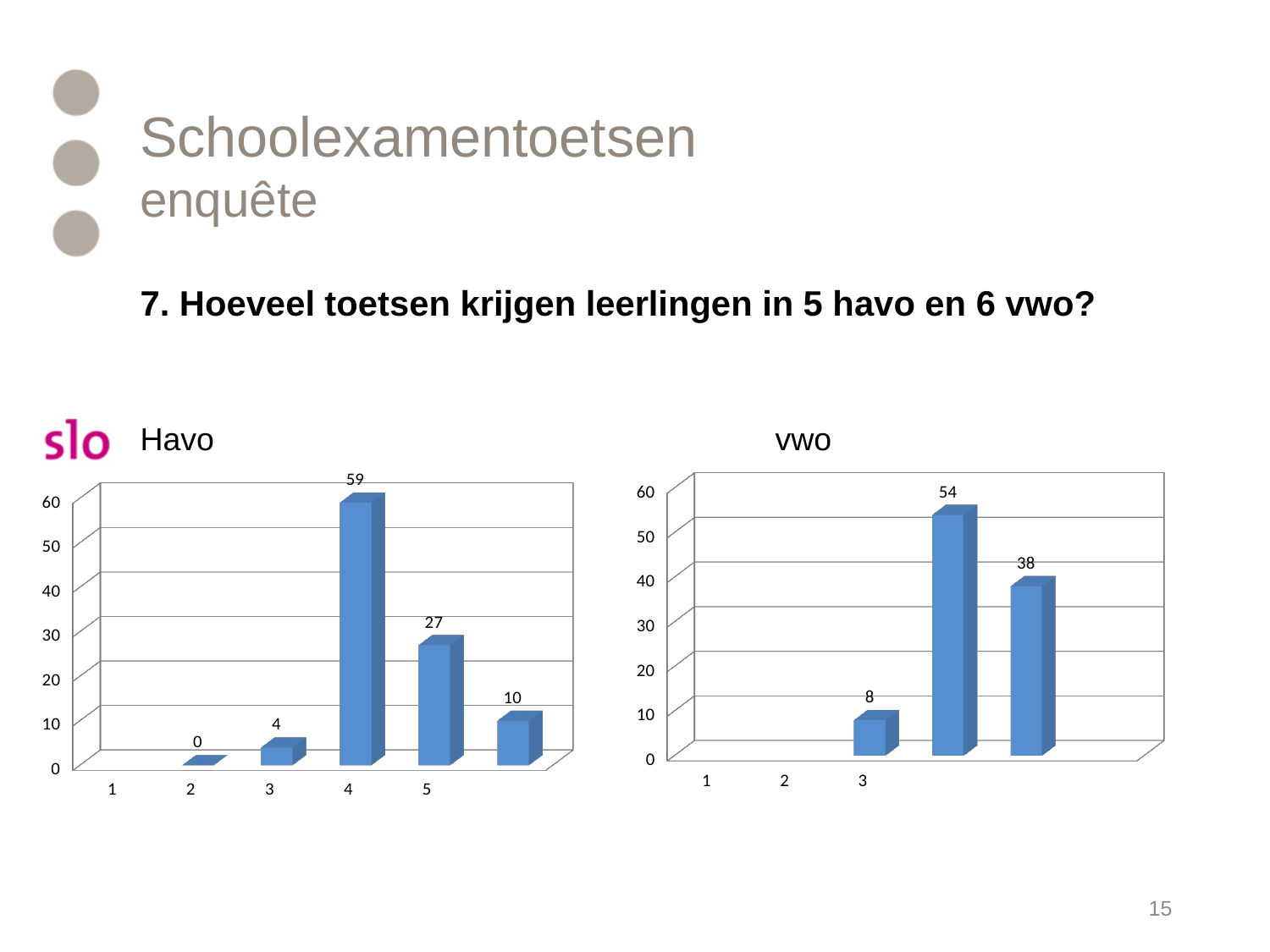
In the Havo chart, is the value for category 4 greater or less than 50? greater In the Havo chart, what is the value for category 3? 4 In the Havo chart, what is the value for category 5? 27 In the Havo chart, what is the value for category 2? 0 In the Havo chart, which is larger, the value for category 3 or the value for category 5? 5 In the Havo chart, what is the value for category 4? 59 In the Havo chart, what is the difference between the values for category 4 and category 5? 32 In the vwo chart, what is the value for category 3? 8 What kind of chart is the vwo chart? bar chart In the Havo chart, which labeled category has the highest value? 4 What is the title of the chart on the left? Havo In the vwo chart, what is the difference between the two tallest bars (54 and 38)? 16